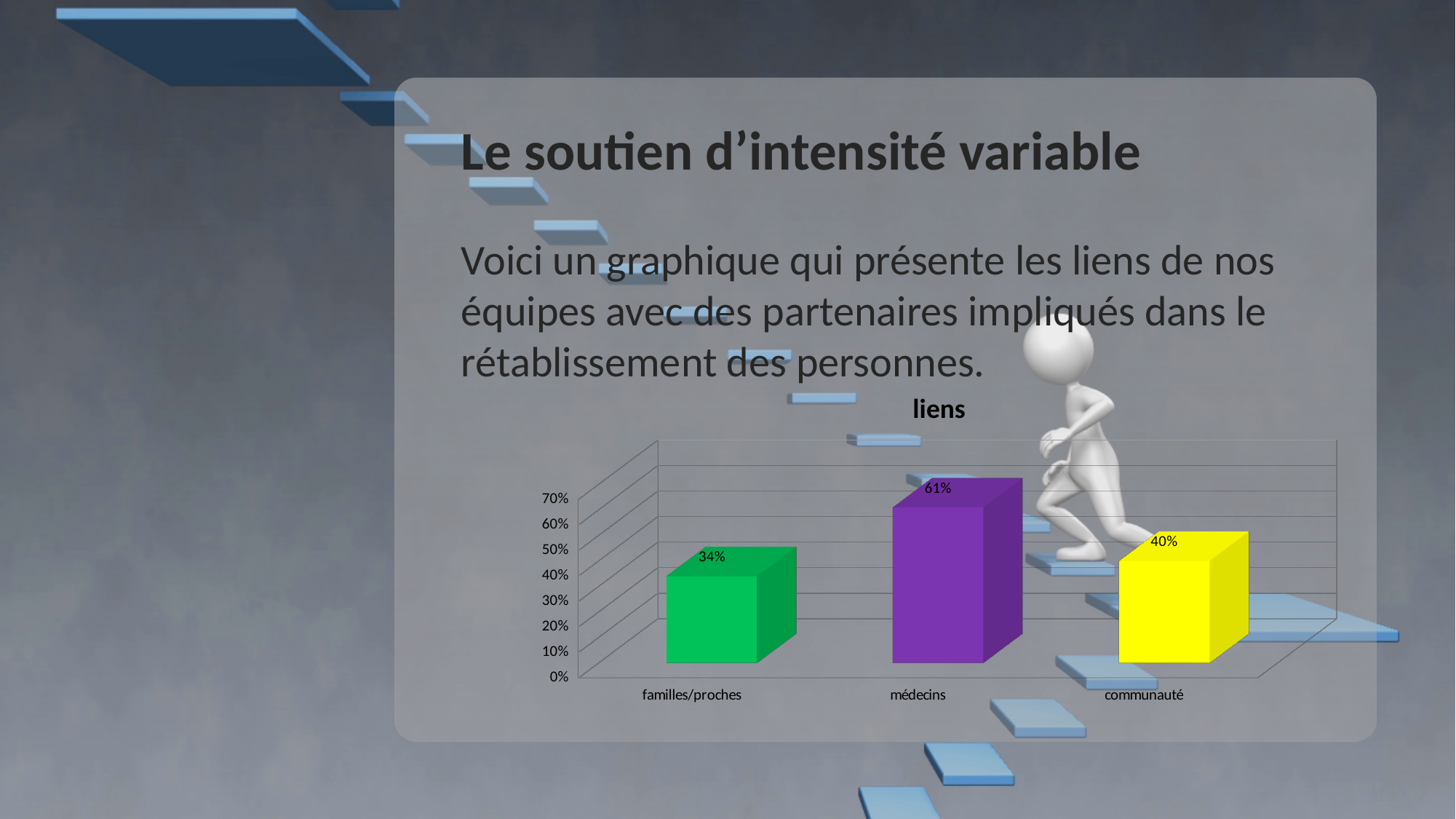
What is the title of the chart? liens What is the value for communauté? 40% Which category has the lowest value? familles/proches Is the value for médecins greater or less than 50%? greater Which is larger, the value for communauté or the value for familles/proches? communauté What is the value for médecins? 61% What is the value for familles/proches? 34% What is the difference between the values for communauté and familles/proches? 6% How many categories are shown in the chart? 3 What kind of chart is shown on the slide? bar chart Which category has the highest value? médecins What is the difference between the values for médecins and familles/proches? 27%